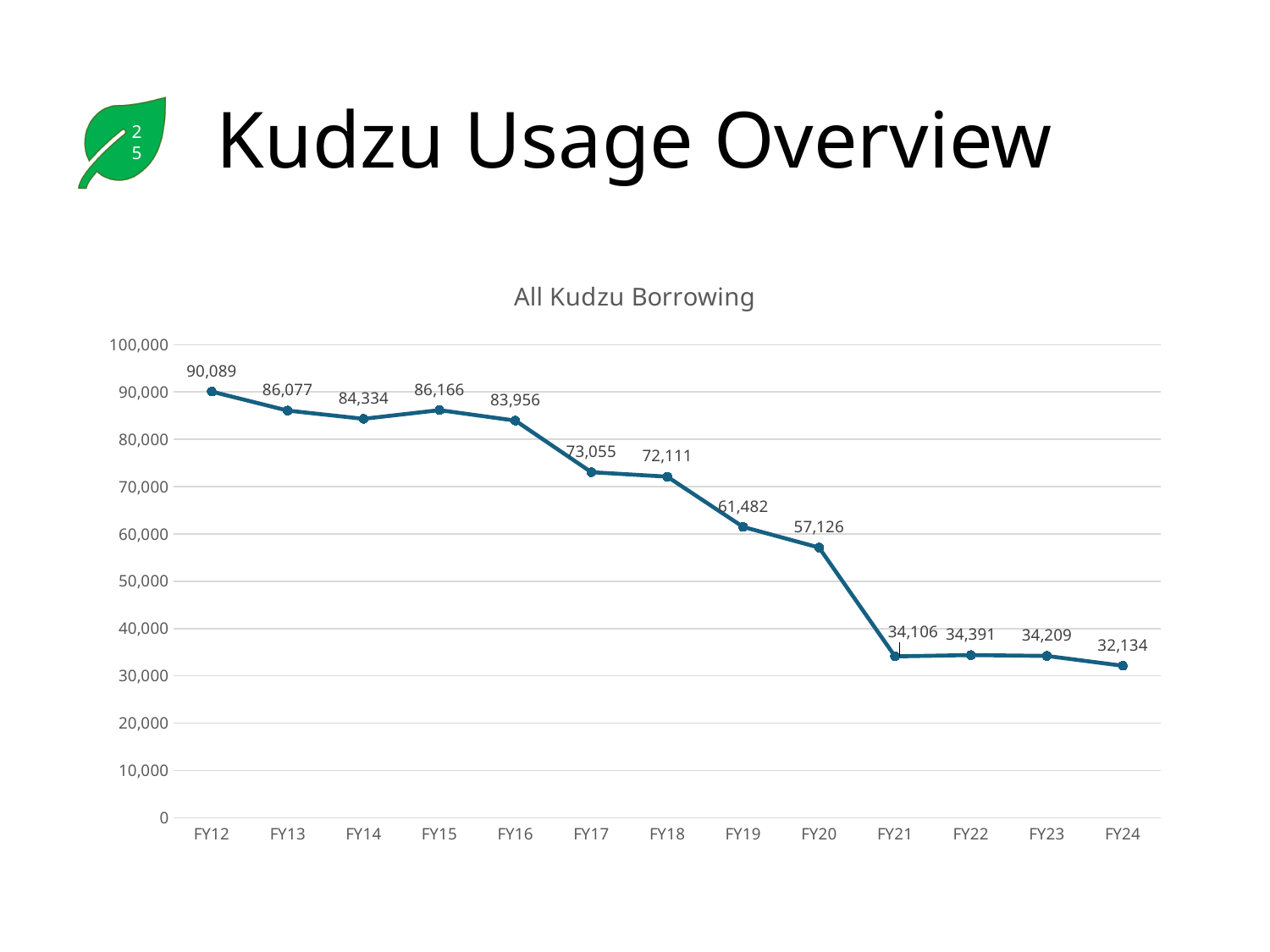
What is the title of the chart? All Kudzu Borrowing What is the difference between the FY12 and FY24 values? 57,955 Is the value for FY19 greater or less than 60,000? greater Which fiscal year has the highest value? FY12 What is the value for FY24? 32,134 What kind of chart is shown on the slide? line chart Which is larger, the value for FY15 or the value for FY16? FY15 What is the difference between the FY20 and FY21 values? 23,020 What is the value for FY12? 90,089 What is the value for FY20? 57,126 How many fiscal years are plotted on the chart? 13 Which fiscal year has the lowest value? FY24